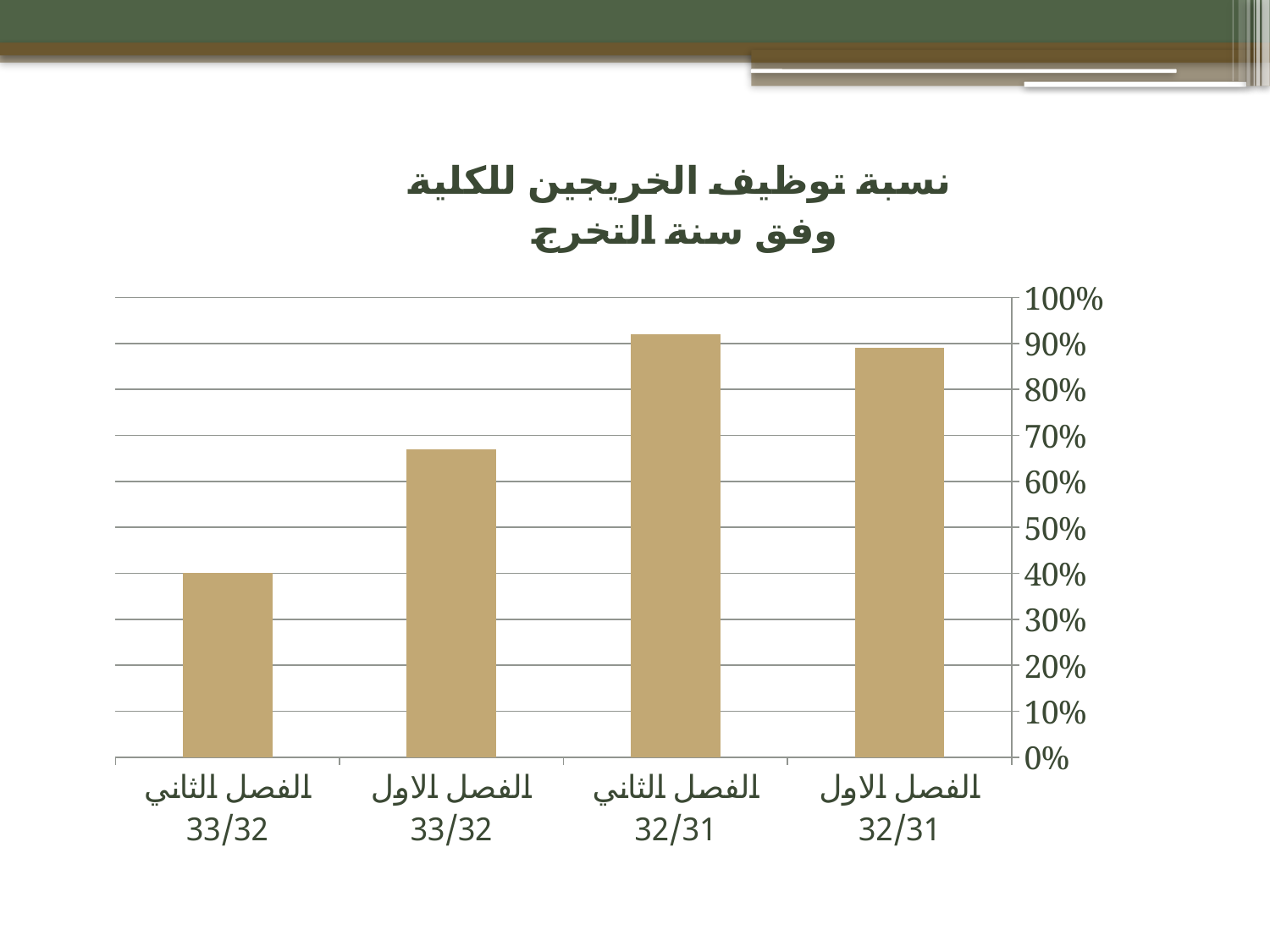
What is the highest value shown on the chart's vertical axis? 100% How many categories are plotted on the x axis of the chart? 4 What is the title of the chart? نسبة توظيف الخريجين للكلية وفق سنة التخرج Which category has the highest bar in the chart? الفصل الثاني 32/31 Is the value for الفصل الاول 32/31 greater or less than 80%? greater Is the value for الفصل الاول 33/32 greater or less than 60%? greater Is the value for الفصل الاول 33/32 greater or less than 70%? less What kind of chart is shown on the slide? bar chart Which is larger, the value for الفصل الاول 33/32 or the value for الفصل الثاني 33/32? الفصل الاول 33/32 Which category has the lowest bar in the chart? الفصل الثاني 33/32